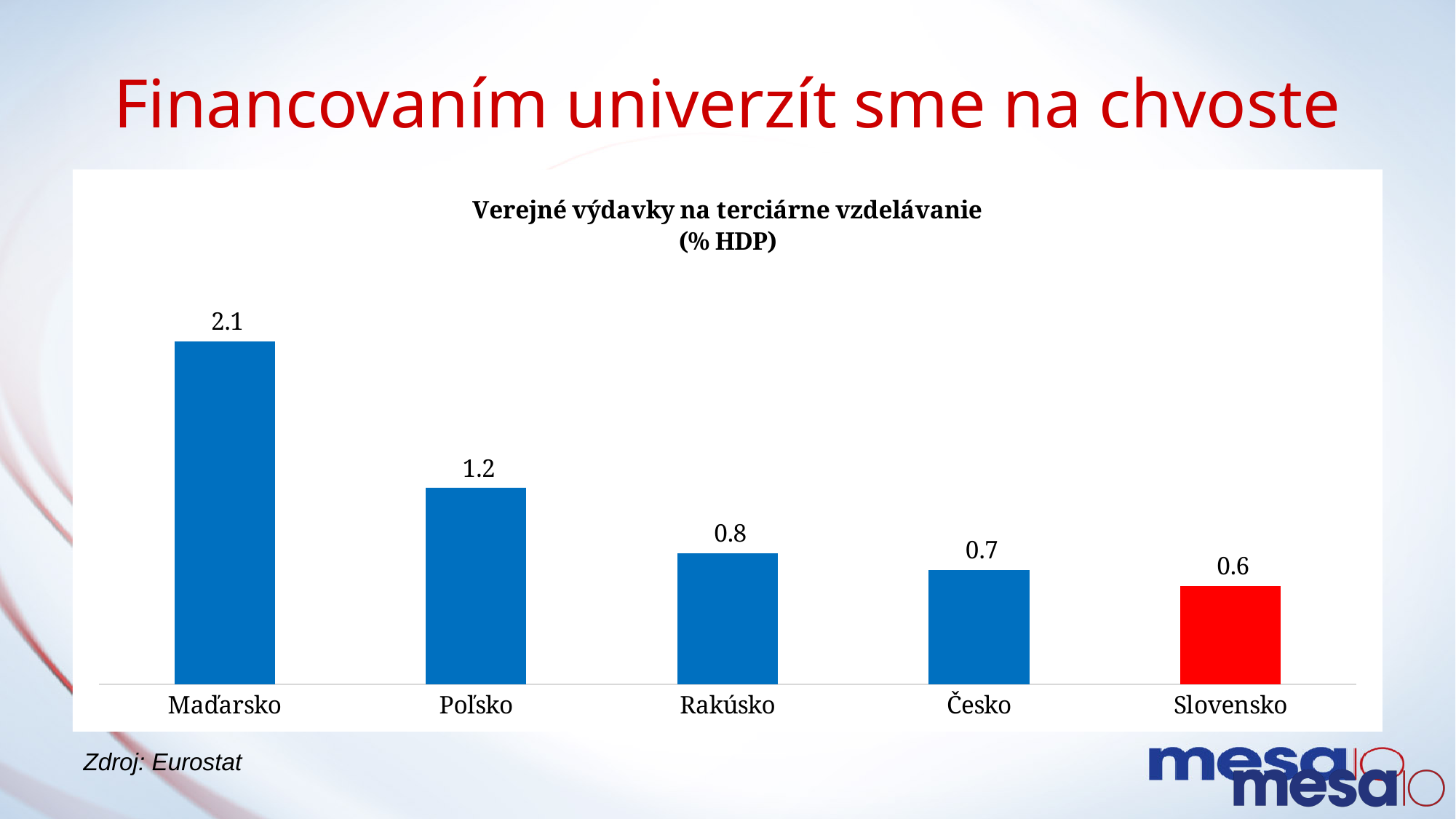
Which country has the lowest value? Slovensko How many countries are shown in the chart? 5 What is the difference between the values for Maďarsko and Poľsko? 0.9 What is the difference between the values for Česko and Slovensko? 0.1 Which is larger, the value for Poľsko or the value for Rakúsko? Poľsko What is the value for Slovensko? 0.6 What kind of chart is shown on the slide? bar chart Which country has the highest value? Maďarsko What is the value for Rakúsko? 0.8 Do the values rise or fall from left to right across the chart? fall Which country's bar is coloured red? Slovensko What is the value for Maďarsko? 2.1